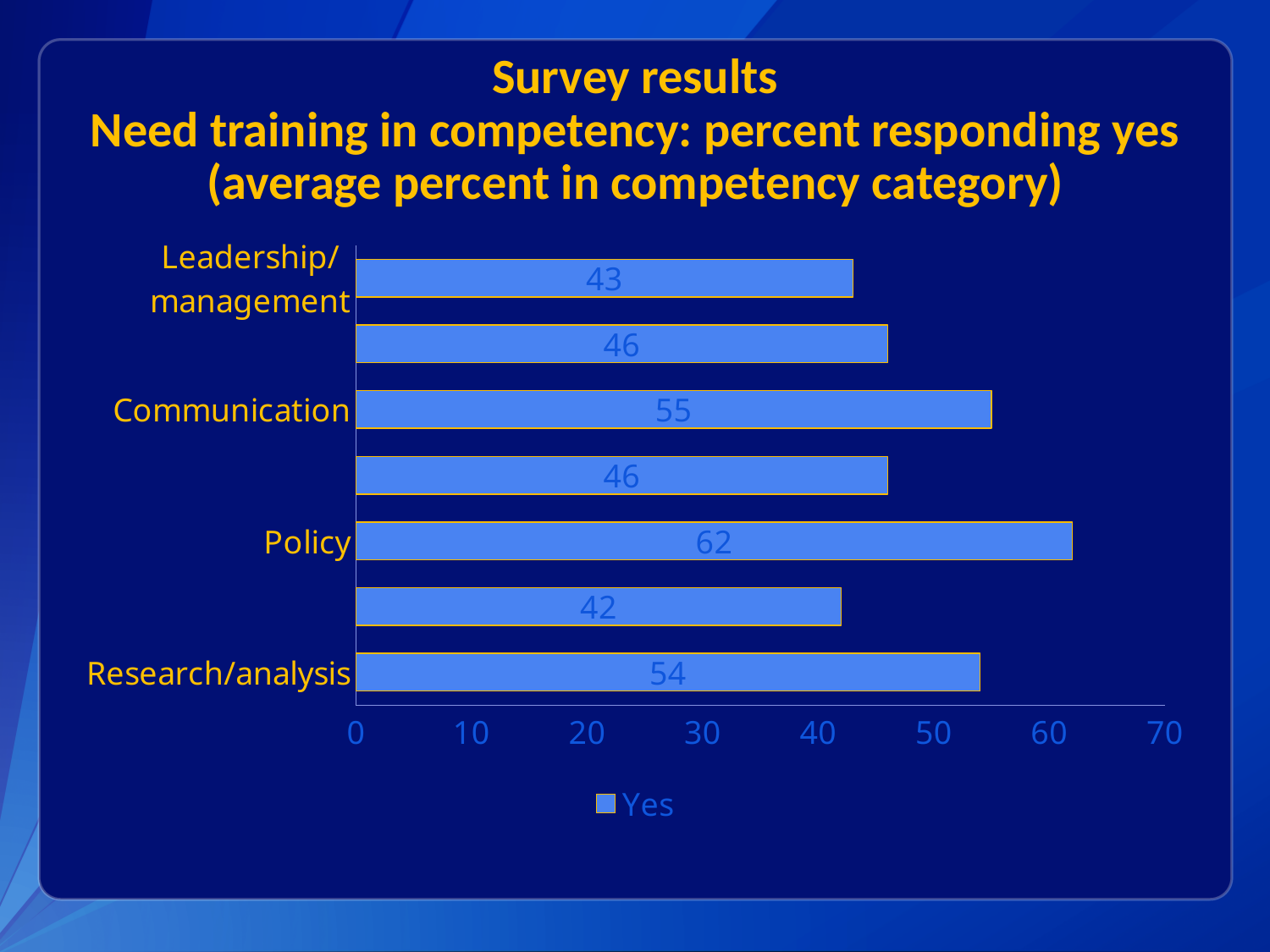
Which category has the highest value? Policy Is the value for Leadership/management greater or less than 50? less What is the difference between the values for Communication and Research/analysis? 1 What is the value for Communication? 55 What is the value for Research/analysis? 54 What is the value for Policy? 62 What is the value for Leadership/management? 43 What is the difference between the values for Policy and Leadership/management? 19 Which is larger, the value for Policy or the value for Communication? Policy What kind of chart is shown on the slide? bar chart How many series does the legend list? 1 How many bars are plotted in the chart? 7